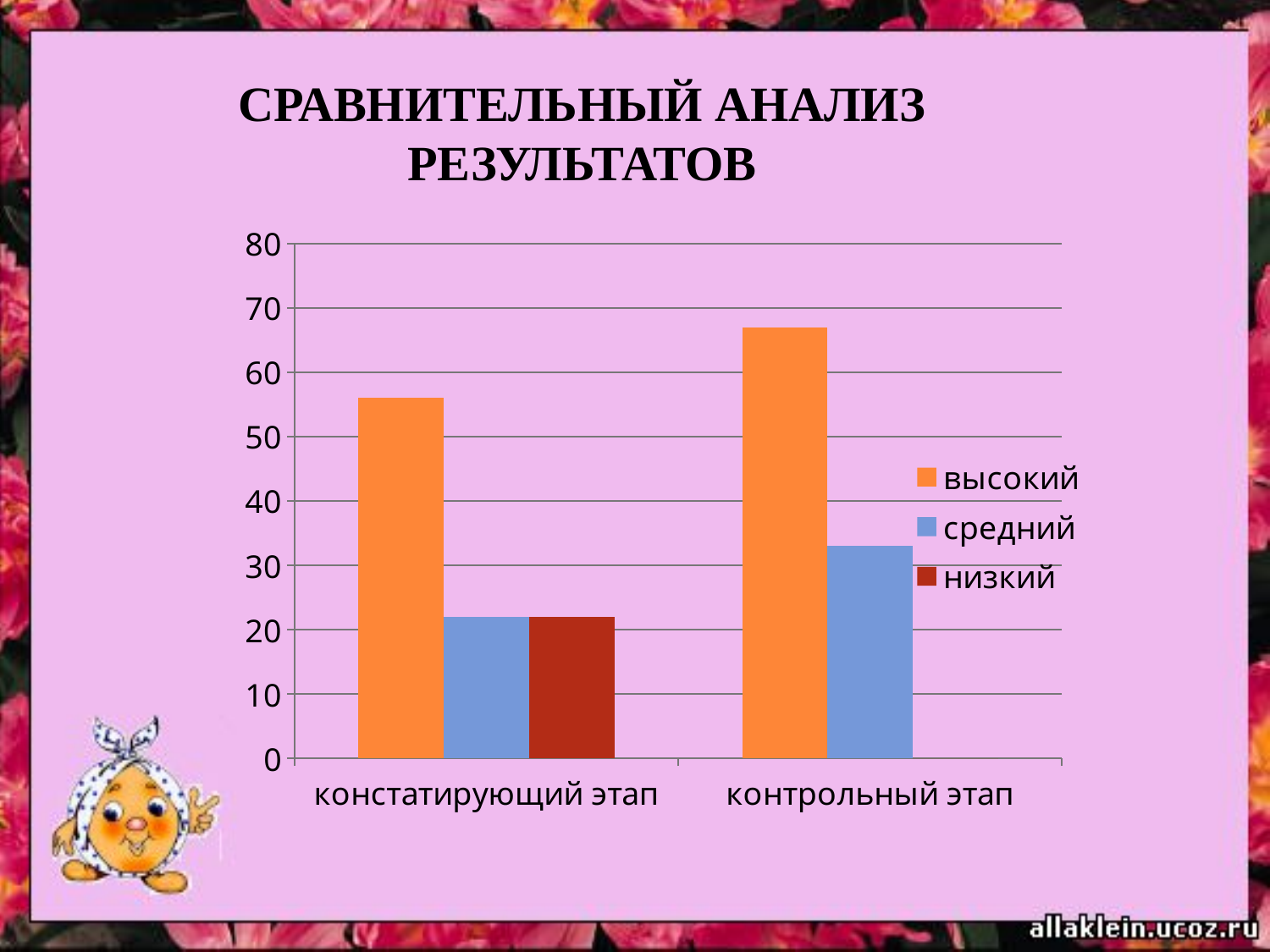
Which is larger: средний in констатирующий этап or средний in контрольный этап? контрольный этап What kind of chart is shown on the slide? bar chart Is the value for высокий in констатирующий этап greater or less than 50? greater Which series is shown in orange in the legend? высокий How many categories are shown on the x axis? 2 Is the value for средний in констатирующий этап greater or less than 30? less Is the value for низкий in констатирующий этап greater or less than 30? less How many series does the legend list? 3 Which series has the highest bar in контрольный этап? высокий What is the title of the slide above the chart? СРАВНИТЕЛЬНЫЙ АНАЛИЗ РЕЗУЛЬТАТОВ Which is larger: высокий in констатирующий этап or высокий in контрольный этап? контрольный этап